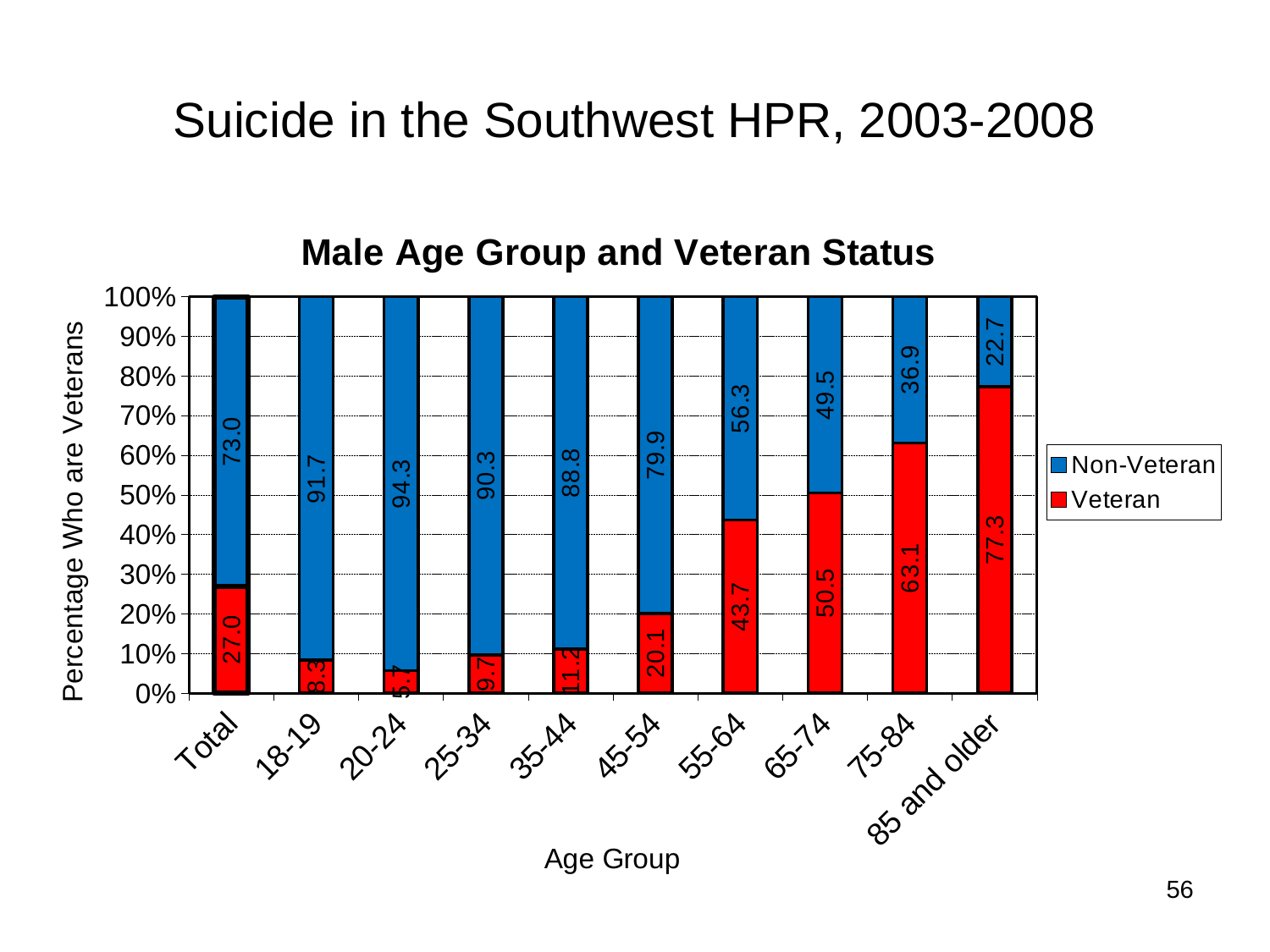
Which has a larger Veteran percentage, the 45-54 group or the 35-44 group? 45-54 What is the Veteran percentage for the Total category? 27.0 Which age group has the highest Veteran percentage? 85 and older What is the title of the y axis? Percentage Who are Veterans Does the Veteran percentage rise or fall across the age groups from 18-19 to 85 and older? Rises How many age group categories are shown on the x axis? 10 What kind of chart is shown on the slide? Stacked bar chart How many series does the legend list? 2 What is the difference between the Veteran percentage for 75-84 and for 65-74? 12.6 What is the Non-Veteran percentage for the 55-64 age group? 56.3 What is the Veteran percentage for the 85 and older age group? 77.3 Which age group has the lowest Non-Veteran percentage? 85 and older